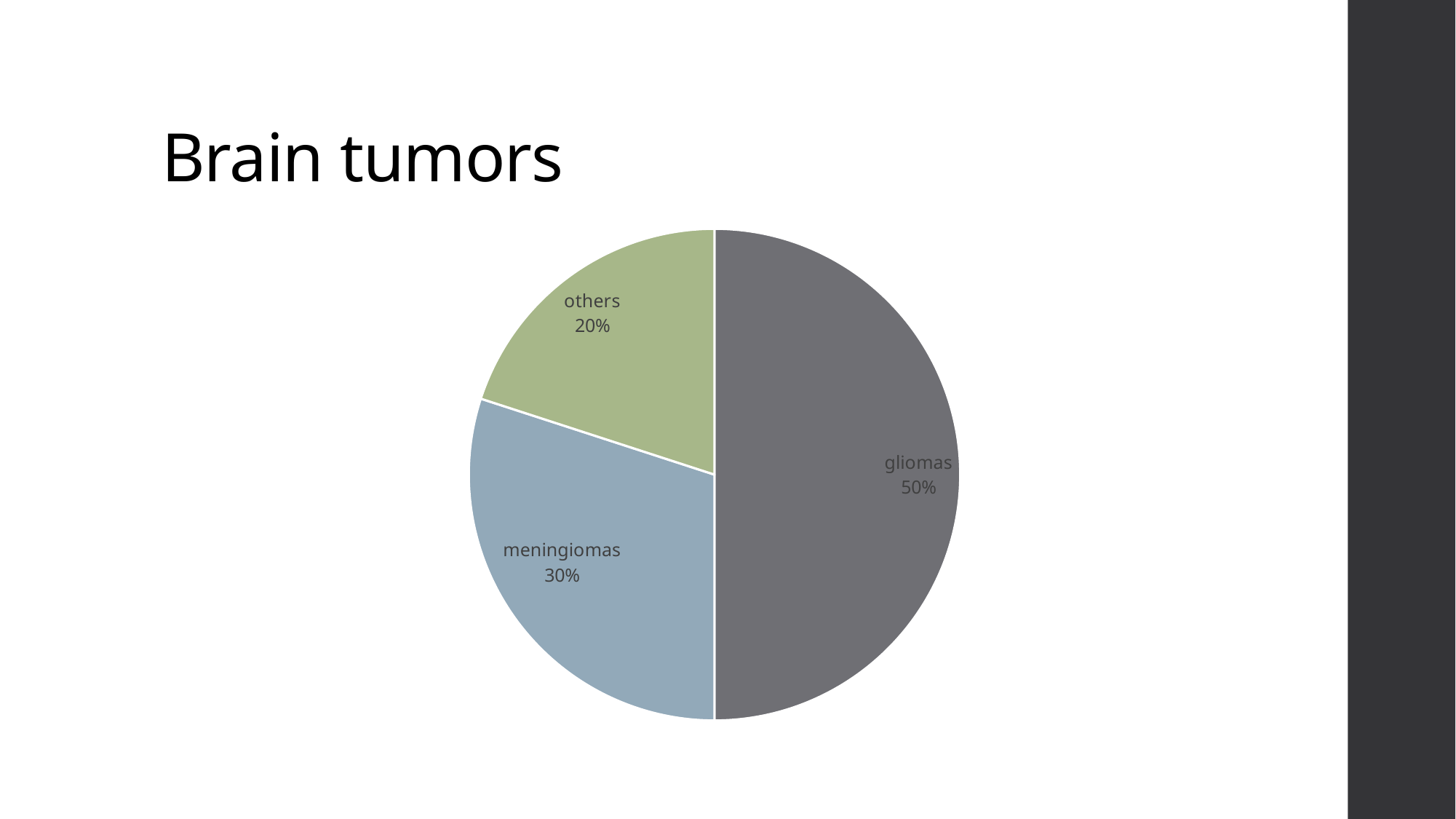
What colour is the gliomas slice? grey Which category has the largest slice of the pie? gliomas What share of the pie does the gliomas slice represent? 50% What is the difference in percentage points between the gliomas and meningiomas slices? 20% What share of the pie does the others slice represent? 20% Which category has the smallest slice of the pie? others What is the title of the slide containing the pie chart? Brain tumors Which slice is larger, meningiomas or others? meningiomas How many slices does the pie chart have? 3 What is the difference in percentage points between the meningiomas and others slices? 10% What type of chart is shown on the slide? pie chart What share of the pie does the meningiomas slice represent? 30%